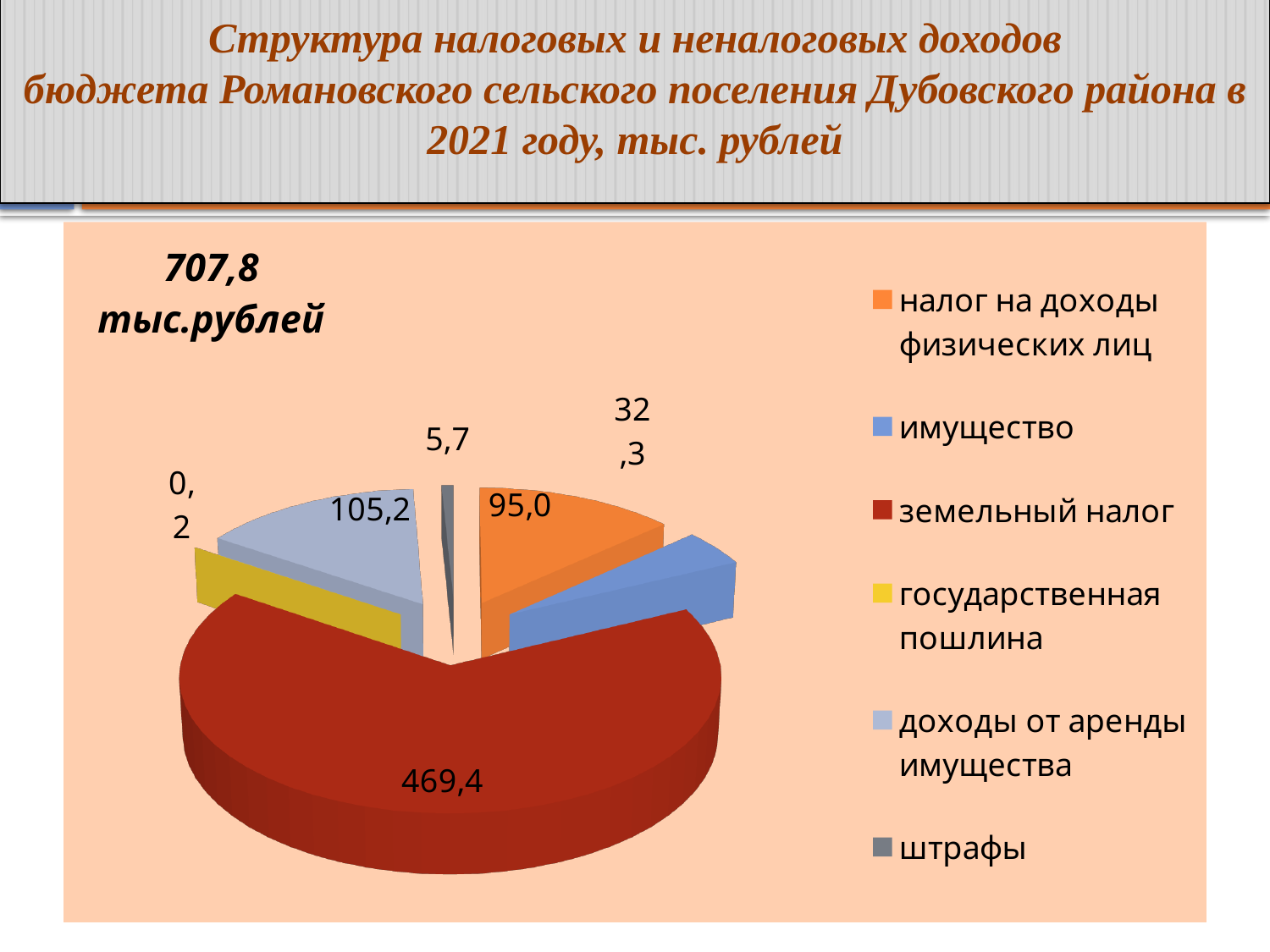
What is the value for земельный налог? 469,4 What is the value for налог на доходы физических лиц? 95,0 What is the value for имущество? 32,3 Which is larger: имущество or штрафы? имущество Which category has the smallest slice of the pie? государственная пошлина What is the value for штрафы? 5,7 Which category has the largest slice of the pie? земельный налог What total amount in тыс. рублей is shown on the chart? 707,8 How many categories does the legend list? 6 What type of chart is shown on the slide? pie chart What is the difference between the values for доходы от аренды имущества and налог на доходы физических лиц? 10,2 What is the value for доходы от аренды имущества? 105,2